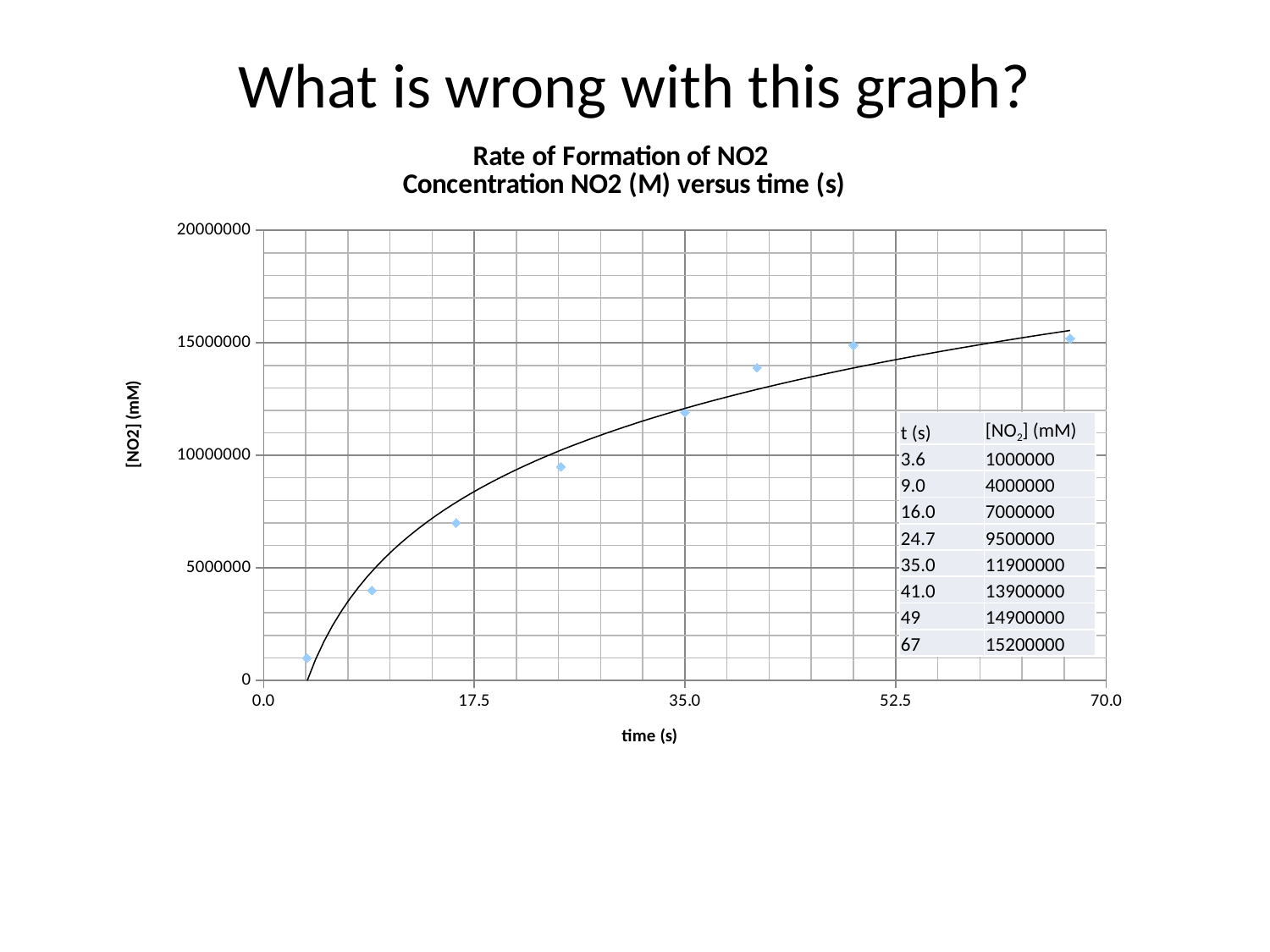
According to the data table, what is the [NO2] value at t = 24.7 s? 9500000 According to the data table, what is the [NO2] value at t = 49 s? 14900000 What is the difference between the [NO2] value at t = 67 s and at t = 3.6 s? 14200000 What kind of chart is shown on the slide? Scatter chart According to the data table, what is the [NO2] value at t = 3.6 s? 1000000 Do the plotted [NO2] values rise or fall as time increases? Rise At which time is the [NO2] value lowest? 3.6 What is the label on the vertical axis of the chart? [NO2] (mM) How many data points are plotted on the chart? 8 Is the [NO2] value at t = 35.0 s greater or less than 10000000? greater Which has a larger [NO2] value: t = 41.0 s or t = 24.7 s? 41.0 At which time is the [NO2] value highest? 67